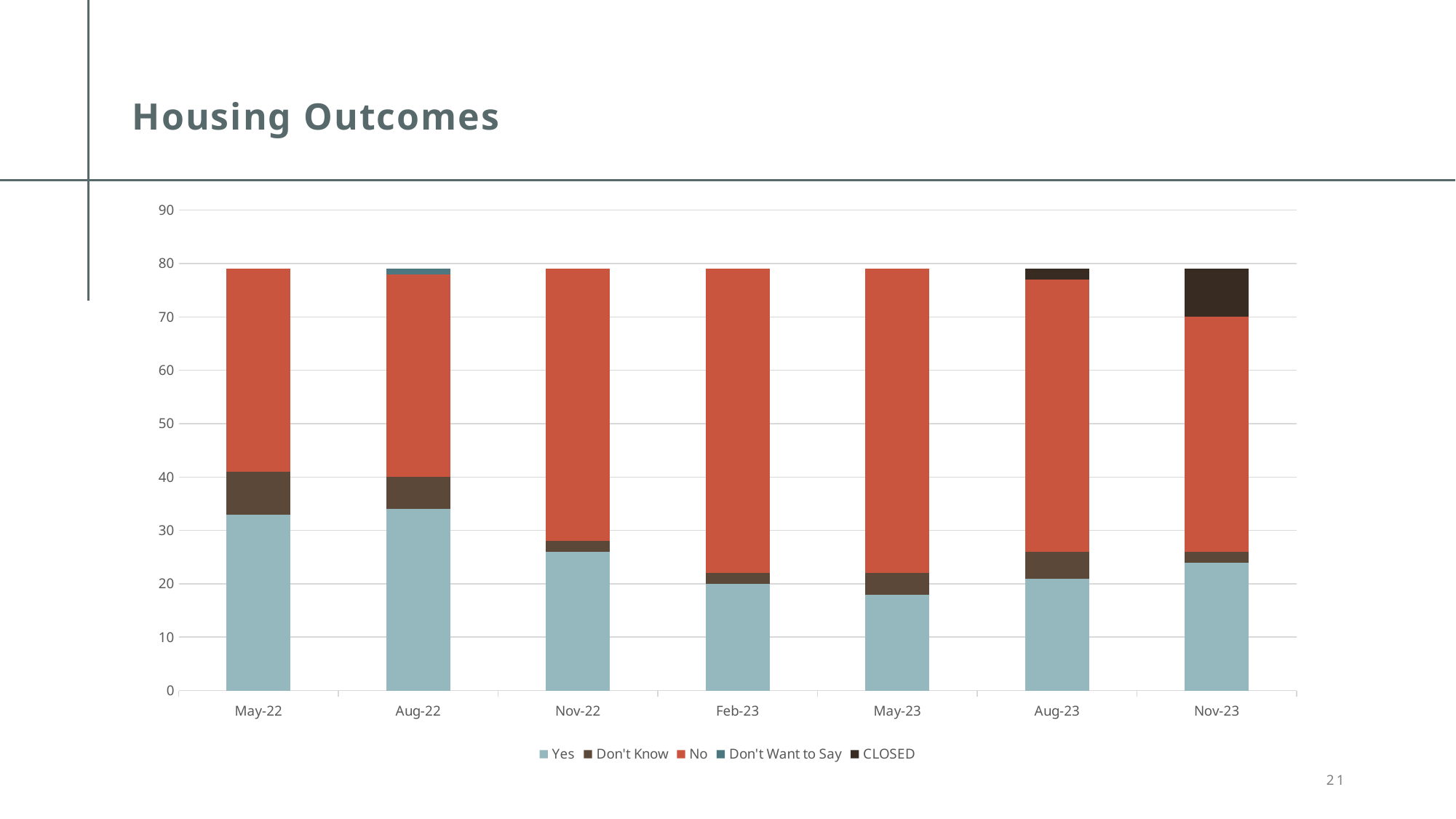
How many series does the chart's legend list? 5 Which period is the only one showing a 'Don't Want to Say' segment? Aug-22 What kind of chart is shown on the slide? Stacked bar chart Is the 'Yes' value for May-23 greater or less than 20? less Is the 'Yes' value for Aug-22 greater or less than 30? greater How many time periods are shown on the x axis of the chart? 7 Is the 'Yes' value for May-22 greater or less than 30? greater Does the 'Yes' segment rise or fall from May-22 to May-23? fall Which period has the largest 'CLOSED' segment? Nov-23 What is the title of the slide containing the chart? Housing Outcomes Which is larger, the 'Yes' value for Nov-22 or the 'Yes' value for Feb-23? Nov-22